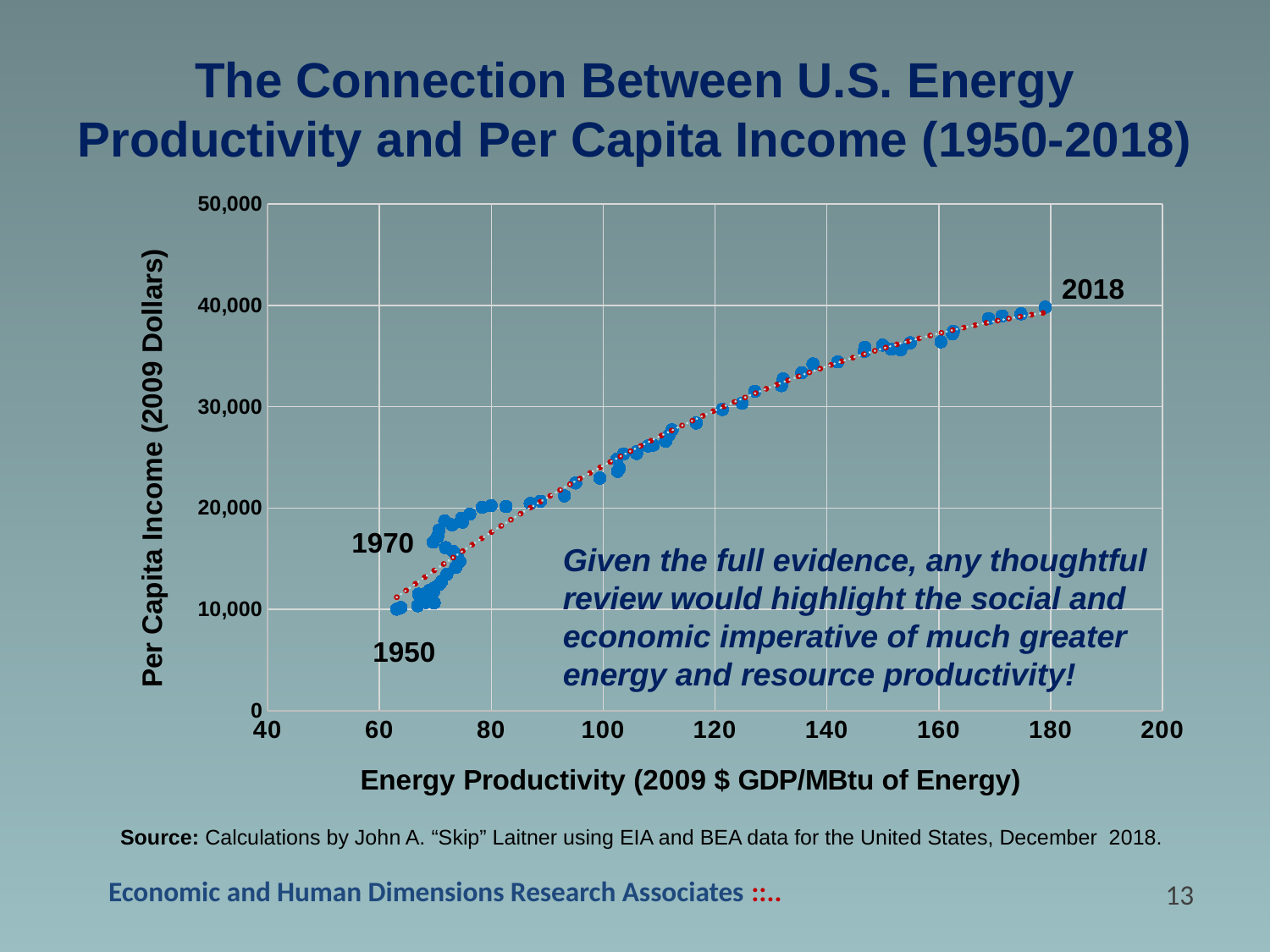
Is the energy productivity for the point labeled 2018 greater or less than 160? greater Of the labeled years 1950, 1970 and 2018, which has the highest per capita income? 2018 Is the per capita income for the point labeled 1950 greater or less than 20,000? less As energy productivity increases along the x axis, does per capita income generally rise or fall? rise Is the per capita income for the point labeled 1970 greater or less than 10,000? greater What is the label of the vertical axis? Per Capita Income (2009 Dollars) What is the title of the chart? The Connection Between U.S. Energy Productivity and Per Capita Income (1950-2018) Of the labeled years 1950, 1970 and 2018, which has the lowest energy productivity? 1950 What kind of chart is shown on the slide? scatter chart Which labeled year has the higher per capita income, 1950 or 1970? 1970